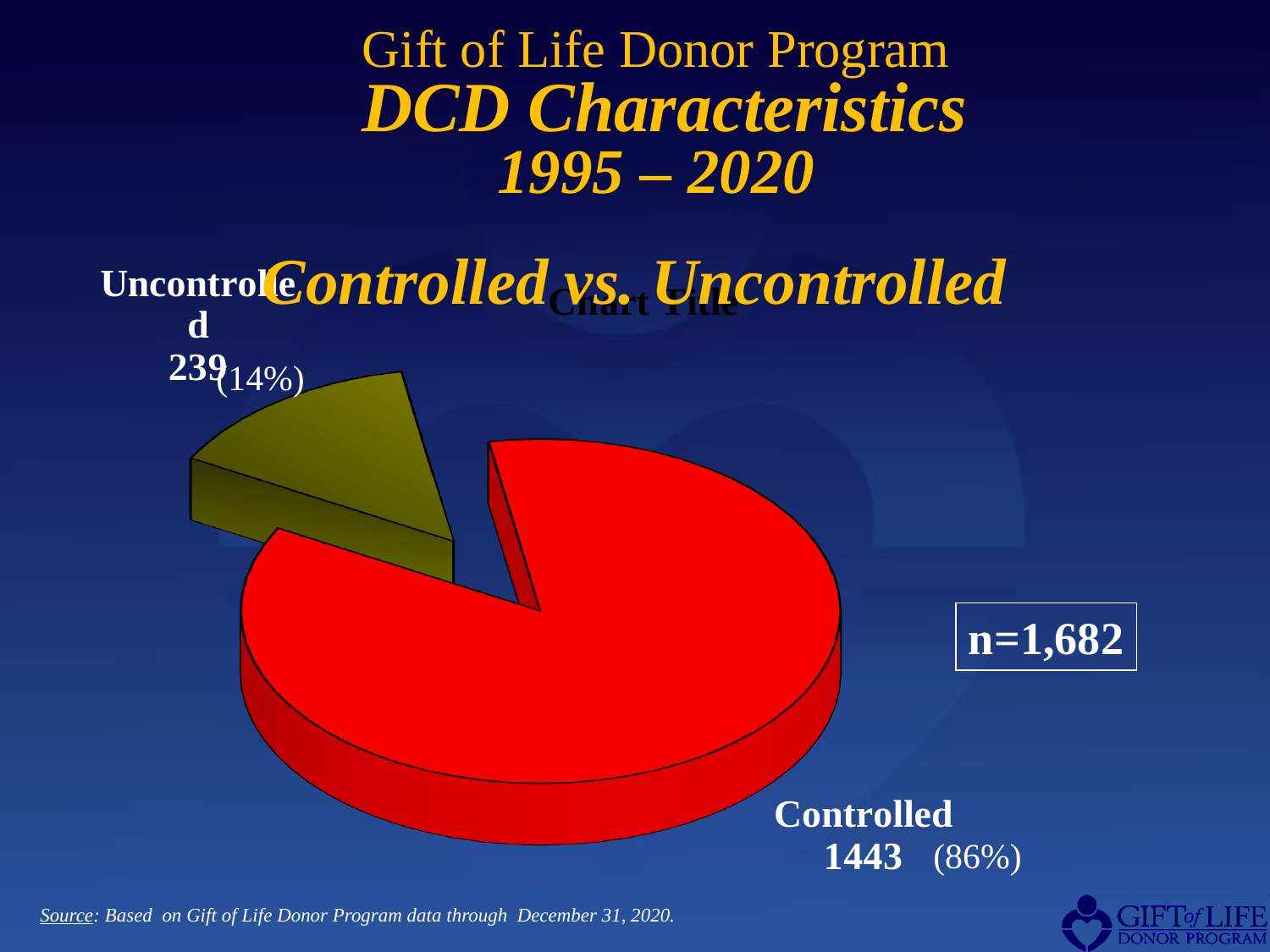
What percentage share of the pie is Uncontrolled? 14% How many slices does the pie chart have? 2 Which is larger, the value for Controlled or the value for Uncontrolled? Controlled What total n is shown in the box next to the pie chart? n=1,682 What is the difference between the Controlled and Uncontrolled values? 1204 What is the value for Uncontrolled? 239 What percentage share of the pie is Controlled? 86% Which category has the largest slice of the pie? Controlled What kind of chart is shown on the slide? pie chart What is the value for Controlled? 1443 Which category has the smallest slice of the pie? Uncontrolled What colour is the Controlled slice of the pie? red